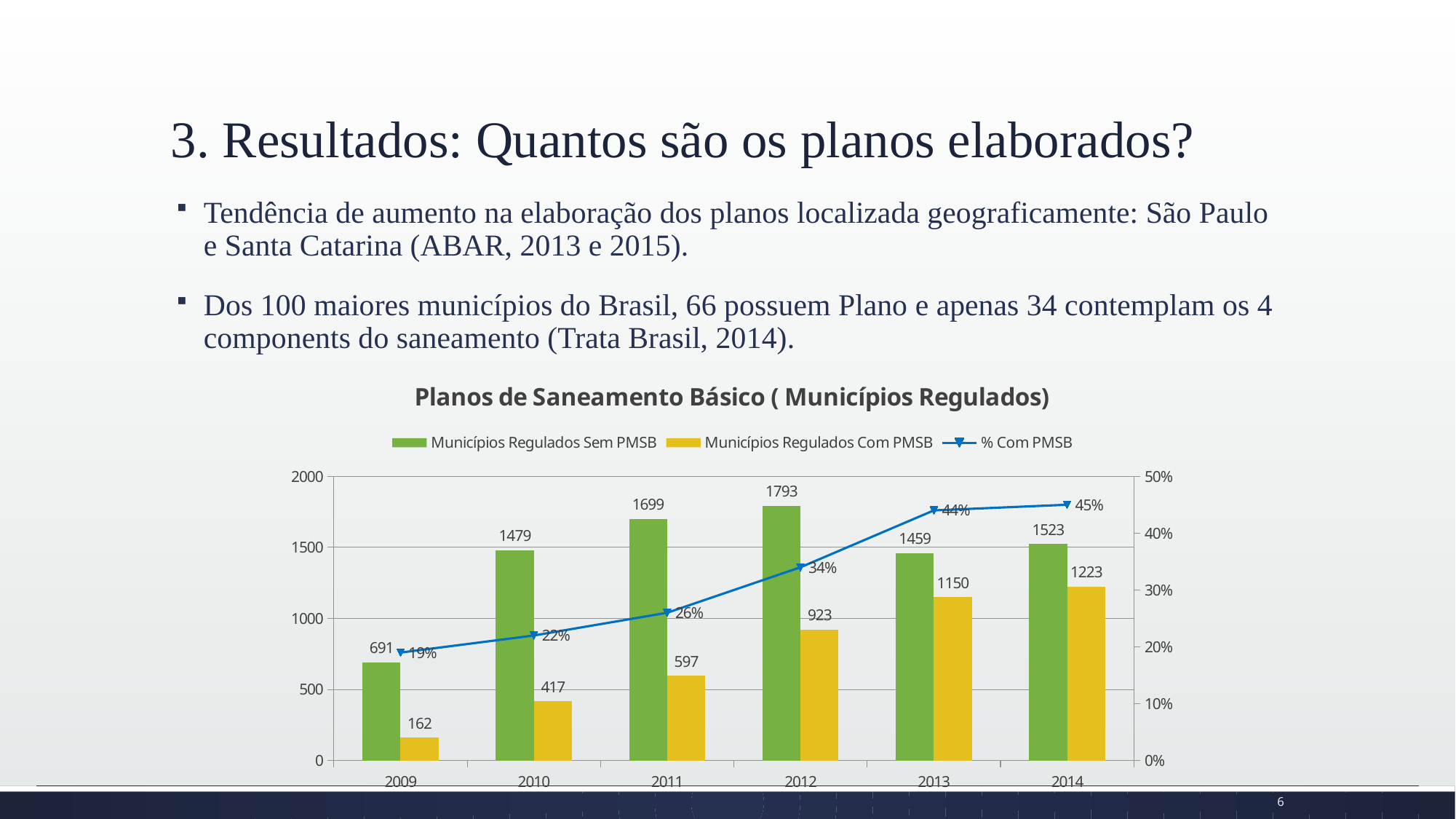
What is the value for Municípios Regulados Sem PMSB in 2012? 1793 What is the title of the chart? Planos de Saneamento Básico ( Municípios Regulados) Does the % Com PMSB line rise or fall from 2009 to 2014? Rises How many series does the legend list? 3 Which is larger in 2011: Municípios Regulados Sem PMSB or Municípios Regulados Com PMSB? Municípios Regulados Sem PMSB In which year is Municípios Regulados Com PMSB lowest? 2009 In which year is Municípios Regulados Sem PMSB highest? 2012 What is the % Com PMSB value for 2013? 44% What is the difference between Municípios Regulados Sem PMSB and Municípios Regulados Com PMSB in 2014? 300 What is the value for Municípios Regulados Com PMSB in 2010? 417 What kind of chart is this? Combined bar and line chart How many years are shown on the x axis? 6